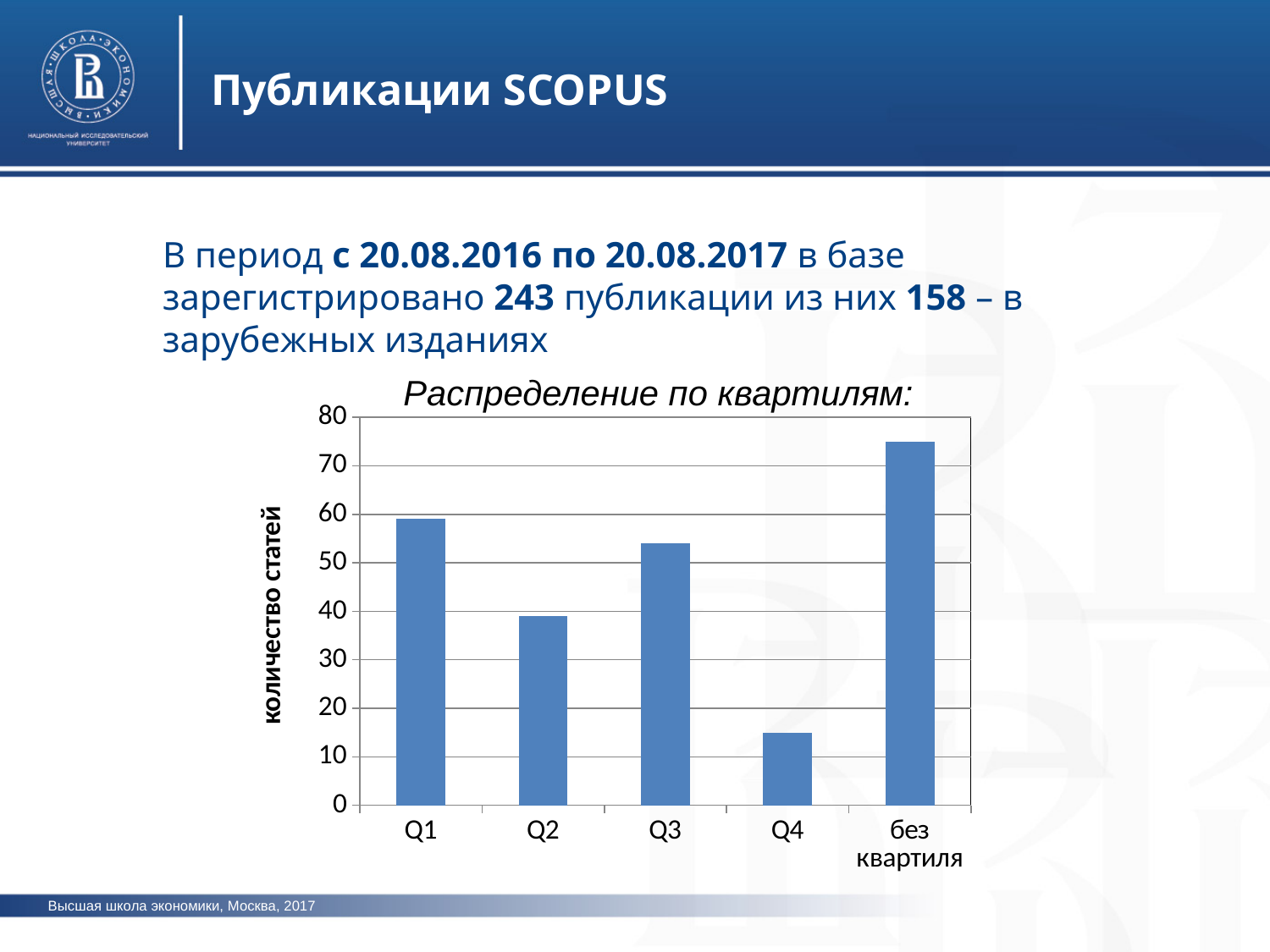
Which category has the highest number of articles? без квартиля What kind of chart is shown on the slide? bar chart Which is larger, the value for Q1 or the value for Q4? Q1 How many categories are shown on the x axis? 5 Which category has the lowest number of articles? Q4 Is the value for Q4 greater or less than 20? less Which is larger, the value for Q2 or the value for Q3? Q3 Is the value for без квартиля greater or less than 70? greater What is the label of the vertical axis? количество статей Is the value for Q1 greater or less than 50? greater What is the title of the chart? Распределение по квартилям: